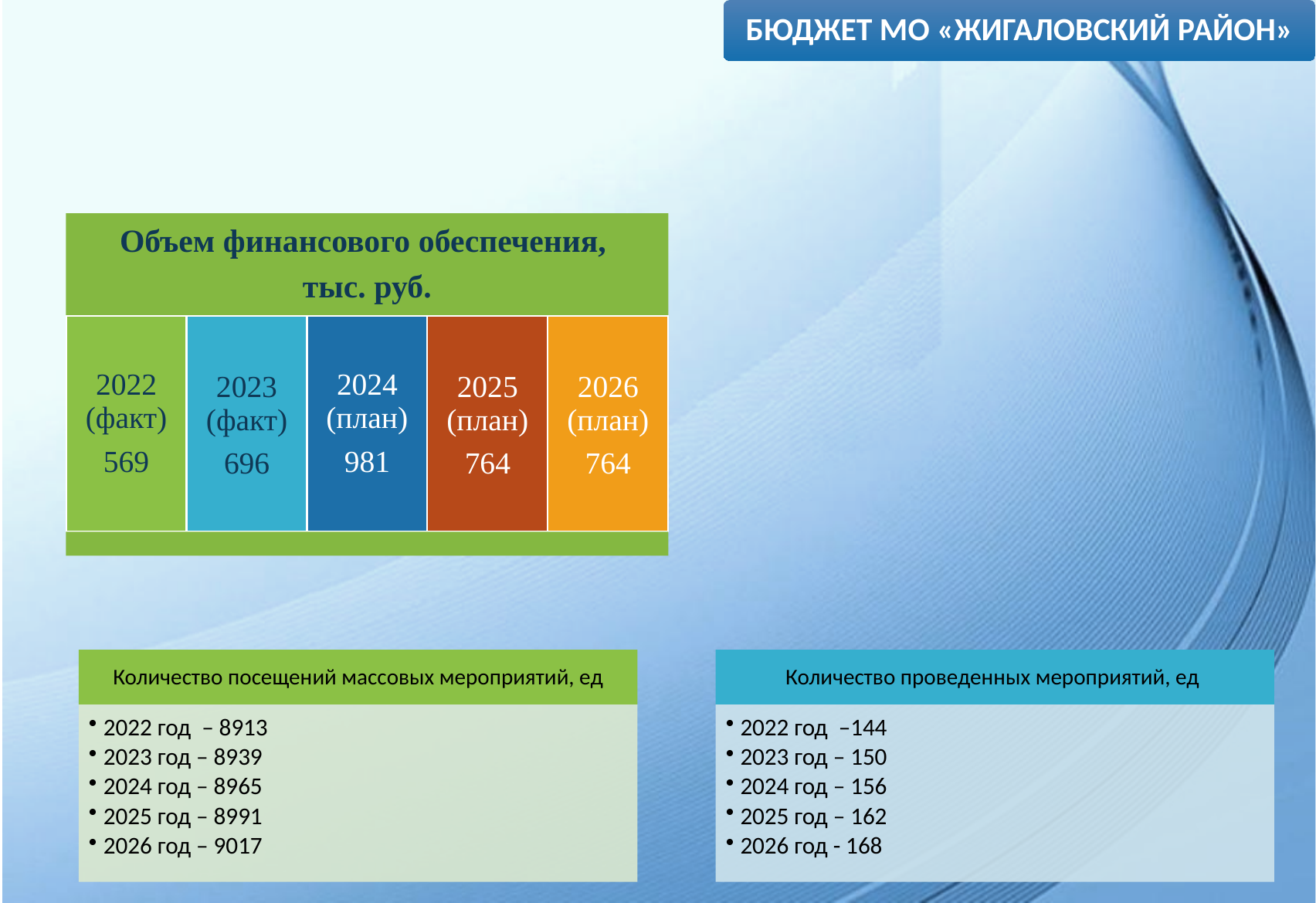
In the 'Объем финансового обеспечения, тыс. руб.' graphic, which year has the highest value? 2024 (план) In the 'Объем финансового обеспечения, тыс. руб.' graphic, how many years are marked as 'план'? 3 In the 'Объем финансового обеспечения, тыс. руб.' graphic, which year has the lowest value? 2022 (факт) In the 'Объем финансового обеспечения, тыс. руб.' graphic, which is larger: the value for 2023 (факт) or the value for 2025 (план)? 2025 (план) In the 'Количество посещений массовых мероприятий, ед' box, what is the value for 2026 год? 9017 In the 'Количество проведенных мероприятий, ед' box, what is the difference between the 2026 год value and the 2022 год value? 24 How many years are shown in the 'Объем финансового обеспечения, тыс. руб.' graphic? 5 In the 'Объем финансового обеспечения, тыс. руб.' graphic, what is the difference between the 2024 (план) value and the 2023 (факт) value? 285 In the 'Объем финансового обеспечения, тыс. руб.' graphic, what is the value for 2024 (план)? 981 In the 'Объем финансового обеспечения, тыс. руб.' graphic, what is the value for 2026 (план)? 764 In the 'Объем финансового обеспечения, тыс. руб.' graphic, what is the value for 2022 (факт)? 569 In the 'Объем финансового обеспечения, тыс. руб.' graphic, what colour is the block for 2024 (план)? Dark blue